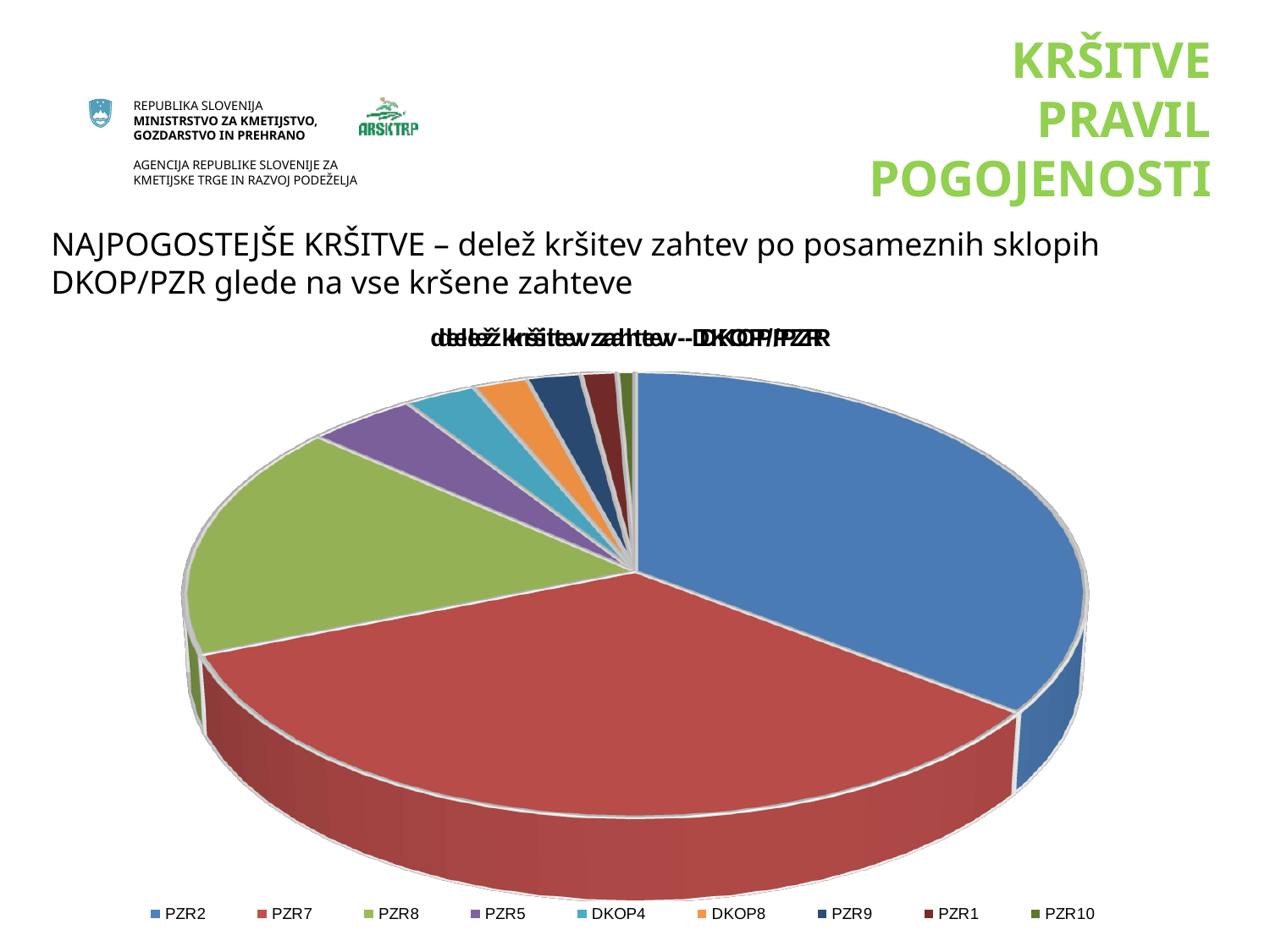
Which slice is larger, PZR2 or PZR8? PZR2 Which category is shown in red in the pie chart? PZR7 Which category is listed last in the legend? PZR10 Which category is listed first in the legend? PZR2 What kind of chart is shown on the slide? pie chart Which category has the smallest slice in the pie chart? PZR10 Which slice is larger, PZR7 or DKOP4? PZR7 Which category is shown in blue in the pie chart? PZR2 How many categories does the legend of the pie chart list? 9 Which slice is larger, PZR5 or PZR10? PZR5